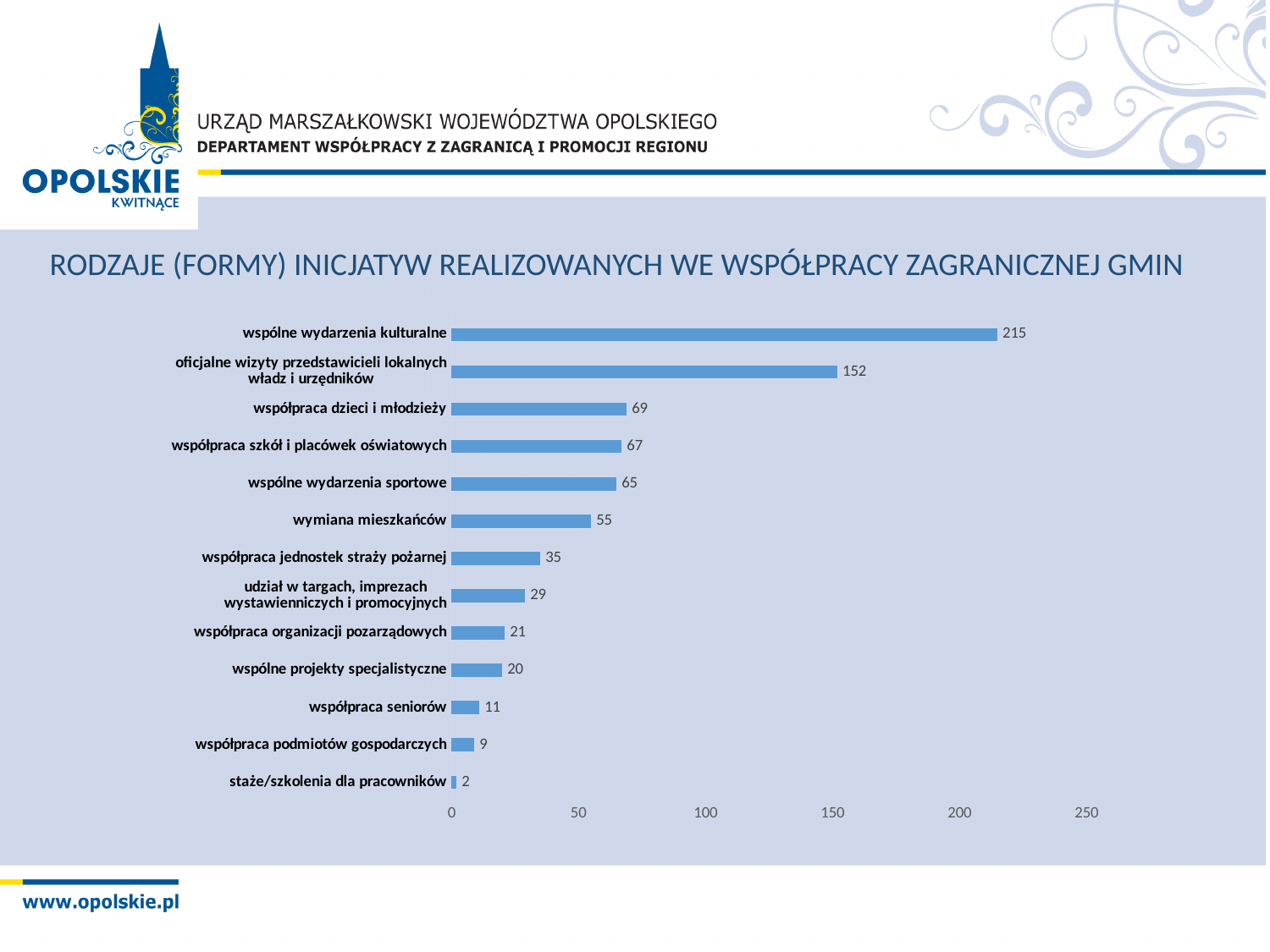
What is the difference between "współpraca dzieci i młodzieży" and "wspólne wydarzenia sportowe"? 4 What is the difference between "wspólne wydarzenia kulturalne" and "oficjalne wizyty przedstawicieli lokalnych władz i urzędników"? 63 Which category has the lowest value? staże/szkolenia dla pracowników What is the value for "wspólne wydarzenia kulturalne"? 215 What kind of chart is shown on the slide? bar chart What is the title of the chart? RODZAJE (FORMY) INICJATYW REALIZOWANYCH WE WSPÓŁPRACY ZAGRANICZNEJ GMIN Which is larger: "współpraca jednostek straży pożarnej" or "udział w targach, imprezach wystawienniczych i promocyjnych"? współpraca jednostek straży pożarnej What is the value for "wymiana mieszkańców"? 55 How many categories are shown in the chart? 13 What is the value for "współpraca seniorów"? 11 Which category has the highest value? wspólne wydarzenia kulturalne Is the value for "oficjalne wizyty przedstawicieli lokalnych władz i urzędników" greater or less than 100? greater